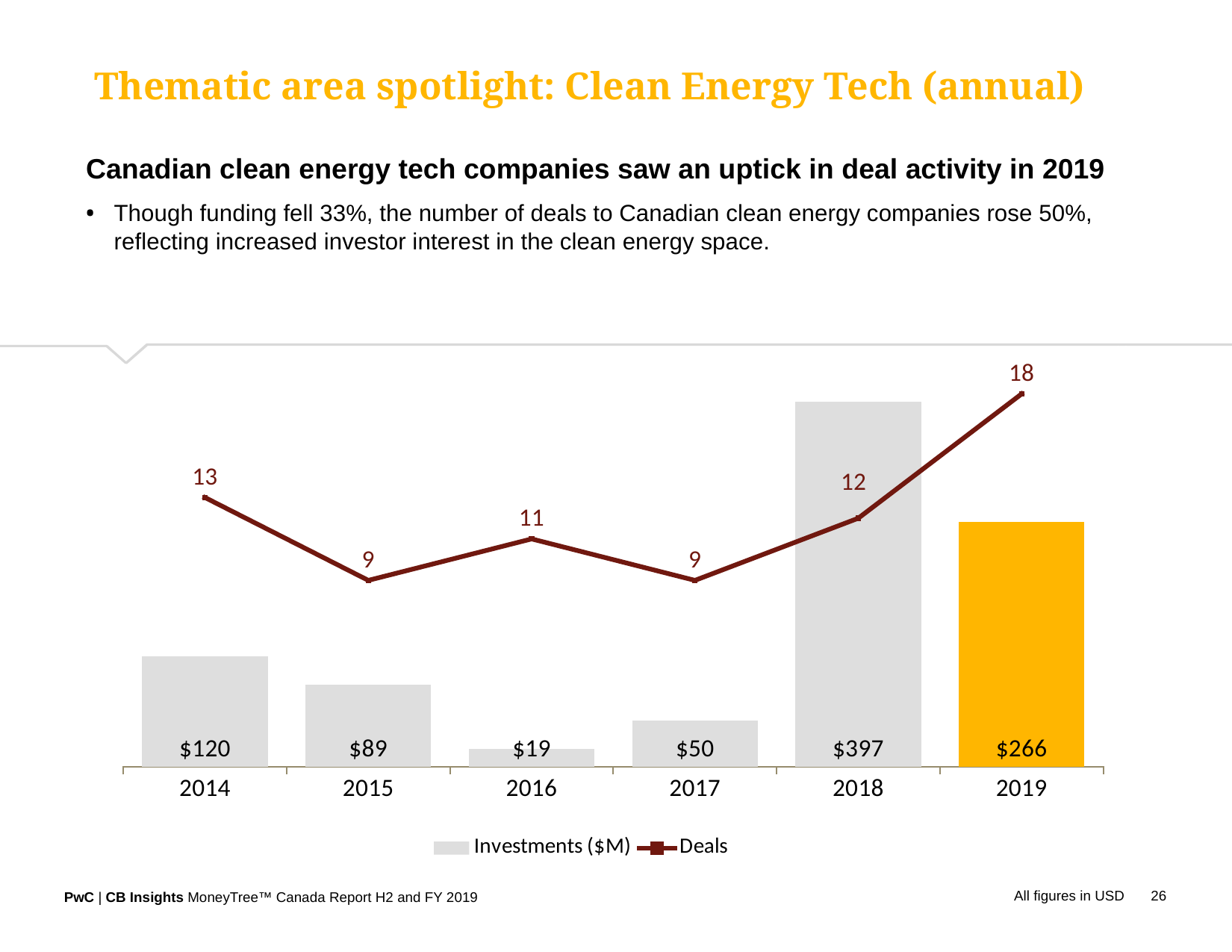
Which year had the lowest number of deals? 2015 and 2017 How many years are shown on the x axis? 6 Did the number of deals rise or fall from 2017 to 2019? Rise How many deals were there in 2019? 18 How many more deals were there in 2019 than in 2018? 6 What is the difference in investments between 2018 and 2019? $131 What kind of chart is used to show Investments ($M)? Bar chart Which year had more deals, 2014 or 2016? 2014 What was the investment amount in 2018? $397 Which year had the highest investment amount? 2018 How many series does the legend list? 2 What was the investment amount in 2016? $19